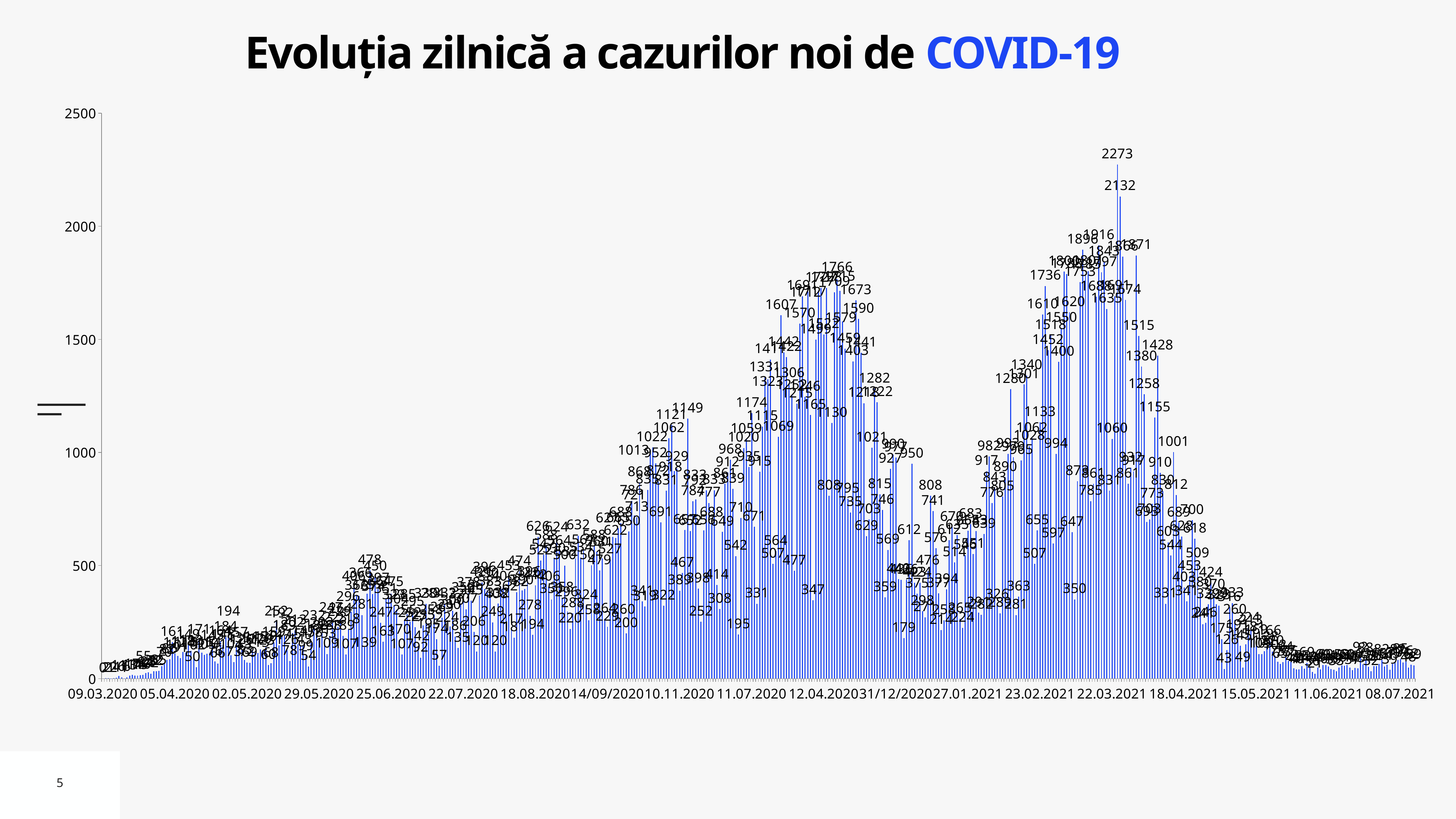
What is the highest daily value labeled on the chart? 2273 What is the second-highest value labeled on the chart, next to the 2273 peak? 2132 Between which two x-axis tick labels does the highest bar (2273) appear? 22.03.2021 and 18.04.2021 After the peak of 2273 in spring 2021, do the values toward the right end of the x axis rise or fall? fall What is the highest value shown on the y axis? 2500 What kind of chart is shown on the slide? bar chart Is the highest bar on the chart greater or less than 2000? greater Is the value of the last bar on the right (08.07.2021) greater or less than 500? less What is the difference between the two highest labeled values, 2273 and 2132? 141 What is the title of the chart? Evoluția zilnică a cazurilor noi de COVID-19 What is the last date label on the x axis? 08.07.2021 What is the first date label on the x axis? 09.03.2020